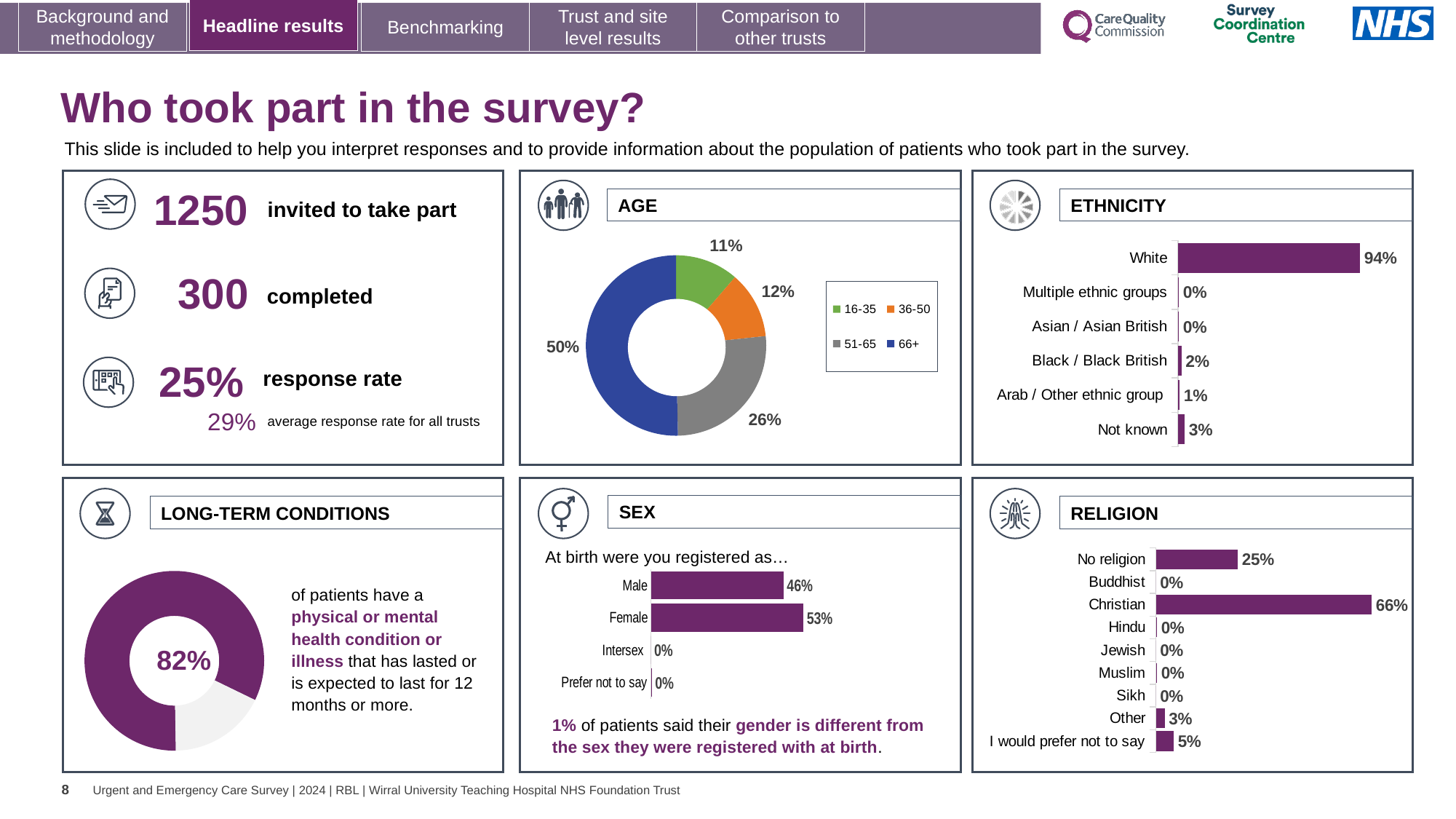
In the SEX chart, which is larger, Male or Female? Female In the LONG-TERM CONDITIONS chart, what percentage of patients have a long-term condition? 82% How many categories are shown in the ETHNICITY chart? 6 In the ETHNICITY chart, what is the value for White? 94% What kind of chart is the AGE chart? Donut chart In the AGE chart, which age group has the smallest share? 16-35 In the AGE chart, what percentage of respondents were aged 66+? 50% In the ETHNICITY chart, what is the difference between Not known and Black / Black British? 1% In the SEX chart, what is the value for Male? 46% How many entries does the legend of the AGE chart list? 4 In the RELIGION chart, what is the value for I would prefer not to say? 5% In the RELIGION chart, which category has the highest value? Christian